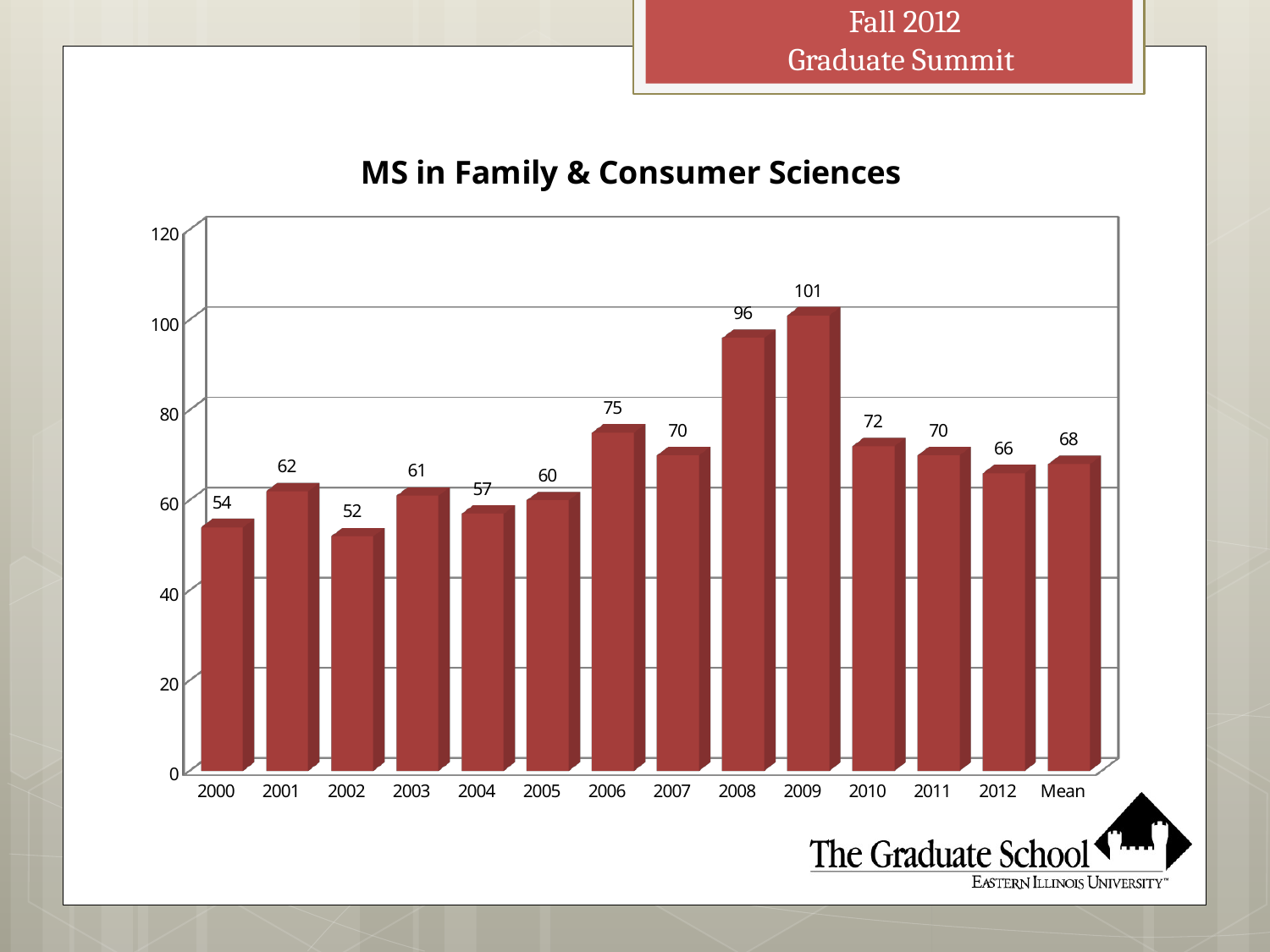
What is the value for 2004? 57 Which year has the highest value? 2009 What is the value for 2009? 101 What kind of chart is this? Bar chart What is the difference between the values for 2009 and 2008? 5 How many bars are shown in the chart? 14 Which category has the lowest value? 2002 What is the title of the chart? MS in Family & Consumer Sciences What is the value shown for Mean? 68 Is the value for 2008 greater or less than 80? greater Which is larger, the value for 2006 or the value for 2010? 2006 Do the values rise or fall from 2006 to 2009? Rise